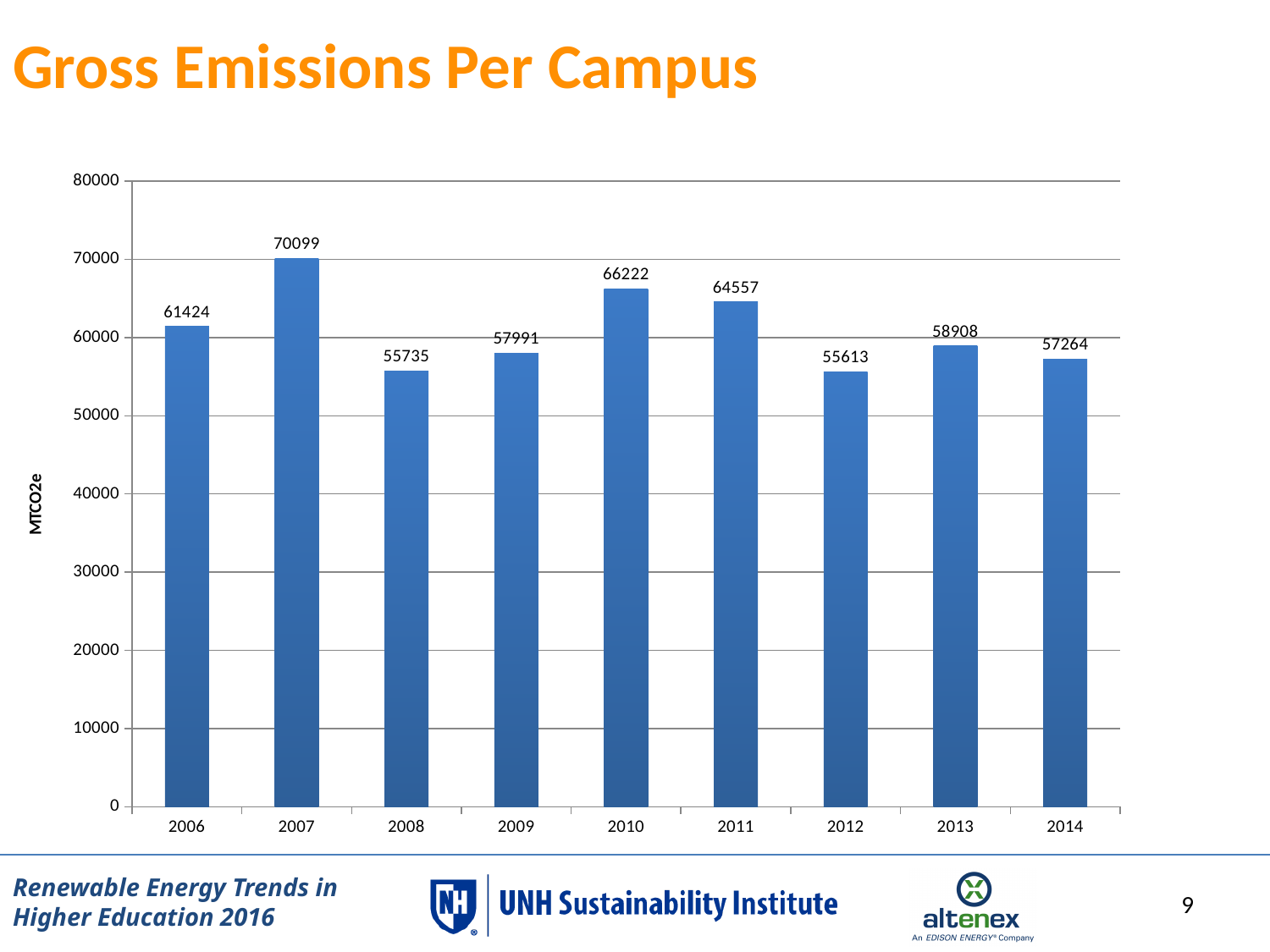
What is the gross emissions value for 2012? 55613 What is the difference between the gross emissions in 2010 and 2011? 1665 Which year has the highest gross emissions? 2007 Which year has the lowest gross emissions? 2012 What is the label on the y axis? MTCO2e Is the value for 2010 greater or less than 60000? greater What is the difference between the gross emissions in 2007 and 2008? 14364 What is the gross emissions value for 2007? 70099 What is the gross emissions value for 2014? 57264 Which year has higher gross emissions, 2006 or 2013? 2006 What kind of chart is shown on the slide? bar chart How many years are shown on the x axis? 9